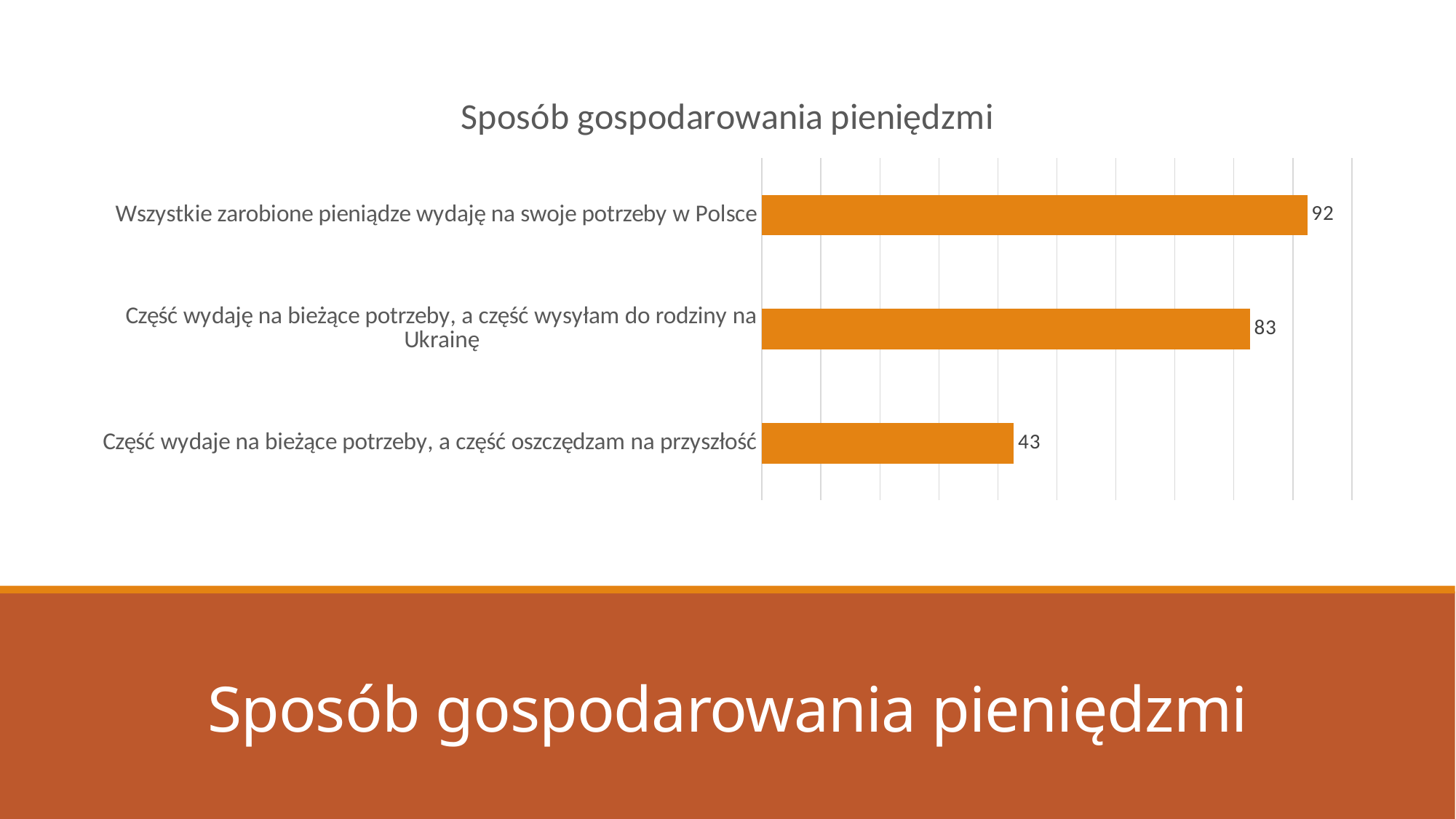
Which is larger: the value for "Część wydaję na bieżące potrzeby, a część wysyłam do rodziny na Ukrainę" or for "Część wydaje na bieżące potrzeby, a część oszczędzam na przyszłość"? Część wydaję na bieżące potrzeby, a część wysyłam do rodziny na Ukrainę What is the value for "Część wydaję na bieżące potrzeby, a część wysyłam do rodziny na Ukrainę"? 83 What is the title of the chart? Sposób gospodarowania pieniędzmi Which category has the lowest value? Część wydaje na bieżące potrzeby, a część oszczędzam na przyszłość What kind of chart is shown on the slide? Bar chart Which category has the highest value? Wszystkie zarobione pieniądze wydaję na swoje potrzeby w Polsce How many categories are shown in the chart? 3 What is the difference between the values for "Wszystkie zarobione pieniądze wydaję na swoje potrzeby w Polsce" and "Część wydaję na bieżące potrzeby, a część wysyłam do rodziny na Ukrainę"? 9 What is the value for "Wszystkie zarobione pieniądze wydaję na swoje potrzeby w Polsce"? 92 What is the difference between the values for "Wszystkie zarobione pieniądze wydaję na swoje potrzeby w Polsce" and "Część wydaje na bieżące potrzeby, a część oszczędzam na przyszłość"? 49 What colour are the bars in the chart? Orange What is the value for "Część wydaje na bieżące potrzeby, a część oszczędzam na przyszłość"? 43